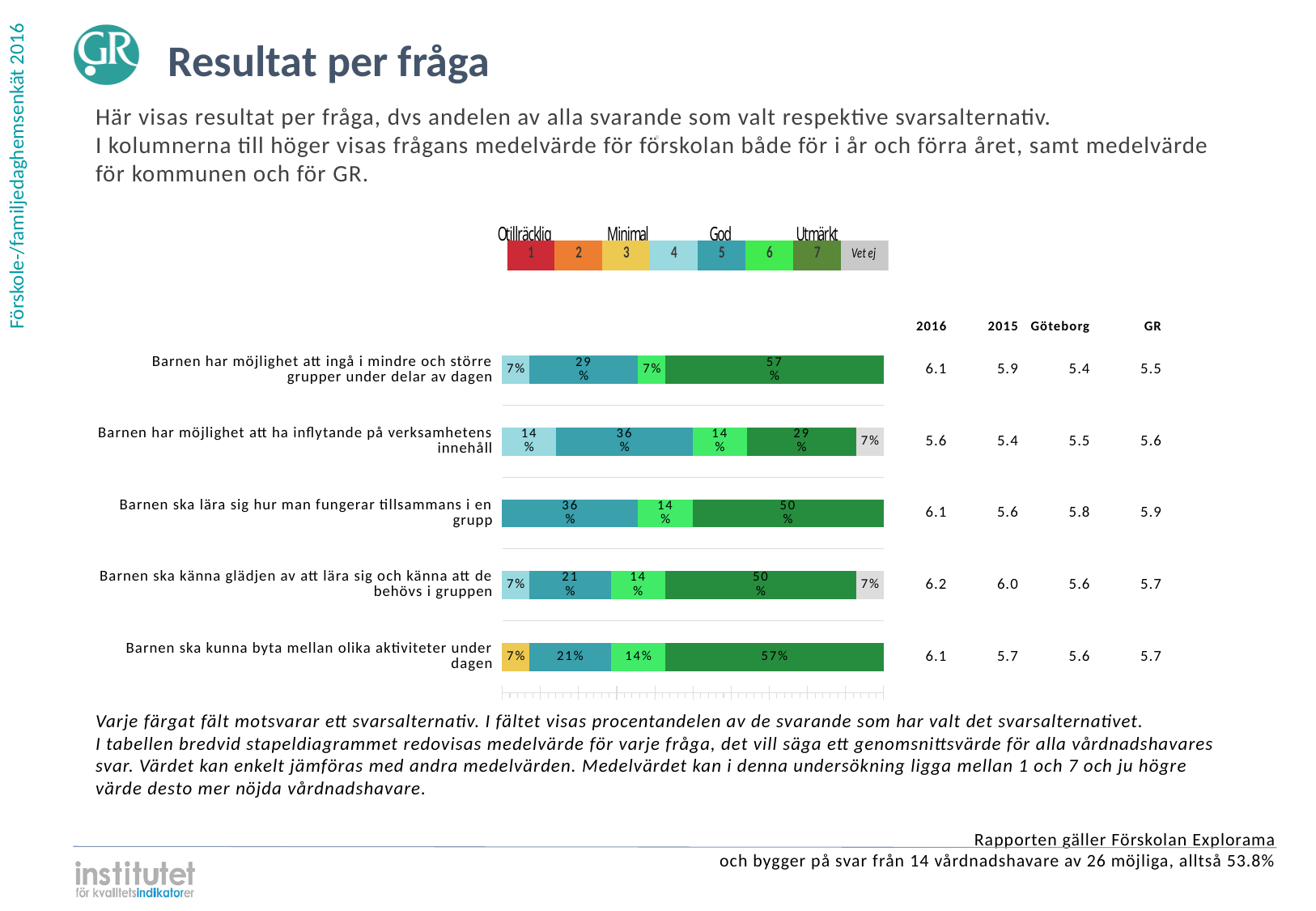
Which has a larger share of option 7 responses: 'Barnen ska lära sig hur man fungerar tillsammans i en grupp' or 'Barnen har möjlighet att ha inflytande på verksamhetens innehåll'? Barnen ska lära sig hur man fungerar tillsammans i en grupp What is the GR mean value for 'Barnen ska lära sig hur man fungerar tillsammans i en grupp'? 5.9 How many questions (categories) are plotted in the bar chart? 5 How many response options does the legend above the chart list, including 'Vet ej'? 8 For 'Barnen har möjlighet att ha inflytande på verksamhetens innehåll', what is the difference between the share choosing option 5 and the share choosing option 6? 22 percentage points What percentage of respondents chose option 7 (Utmärkt) for 'Barnen har möjlighet att ingå i mindre och större grupper under delar av dagen'? 57% Which response option label in the legend is shown in red? 1 (Otillräcklig) What kind of chart is shown on the slide? Stacked bar chart What is the 2016 mean value for 'Barnen ska känna glädjen av att lära sig och känna att de behövs i gruppen'? 6.2 What percentage chose option 5 for 'Barnen har möjlighet att ha inflytande på verksamhetens innehåll'? 36% What percentage answered 'Vet ej' for 'Barnen ska känna glädjen av att lära sig och känna att de behövs i gruppen'? 7% Which question has the lowest share of respondents choosing option 7 (the dark green segment)? Barnen har möjlighet att ha inflytande på verksamhetens innehåll